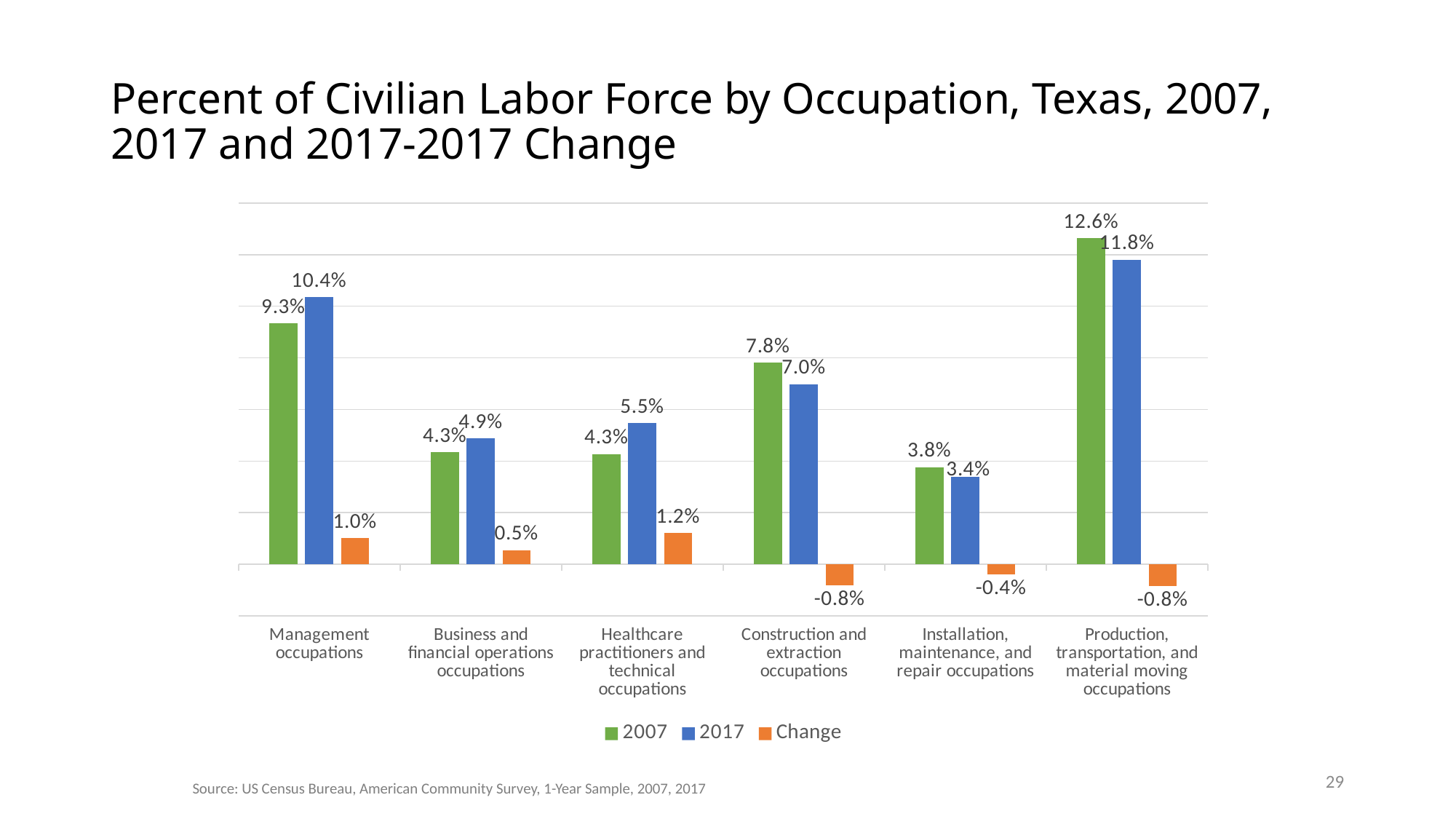
What was the 2017 value for Management occupations? 10.4% What was the 2007 value for Construction and extraction occupations? 7.8% How many occupation categories are shown on the x axis? 6 What is the Change value for Healthcare practitioners and technical occupations? 1.2% What kind of chart is shown on the slide? Bar chart Which occupation category has the lowest 2007 value? Installation, maintenance, and repair occupations Which occupation category has the highest 2017 value? Production, transportation, and material moving occupations How many series does the legend list? 3 Which is larger for Business and financial operations occupations, the 2007 value or the 2017 value? 2017 Which colour represents the Change series in the legend? Orange What is the Change value for Installation, maintenance, and repair occupations? -0.4% What is the difference between the 2007 and 2017 values for Production, transportation, and material moving occupations? 0.8%